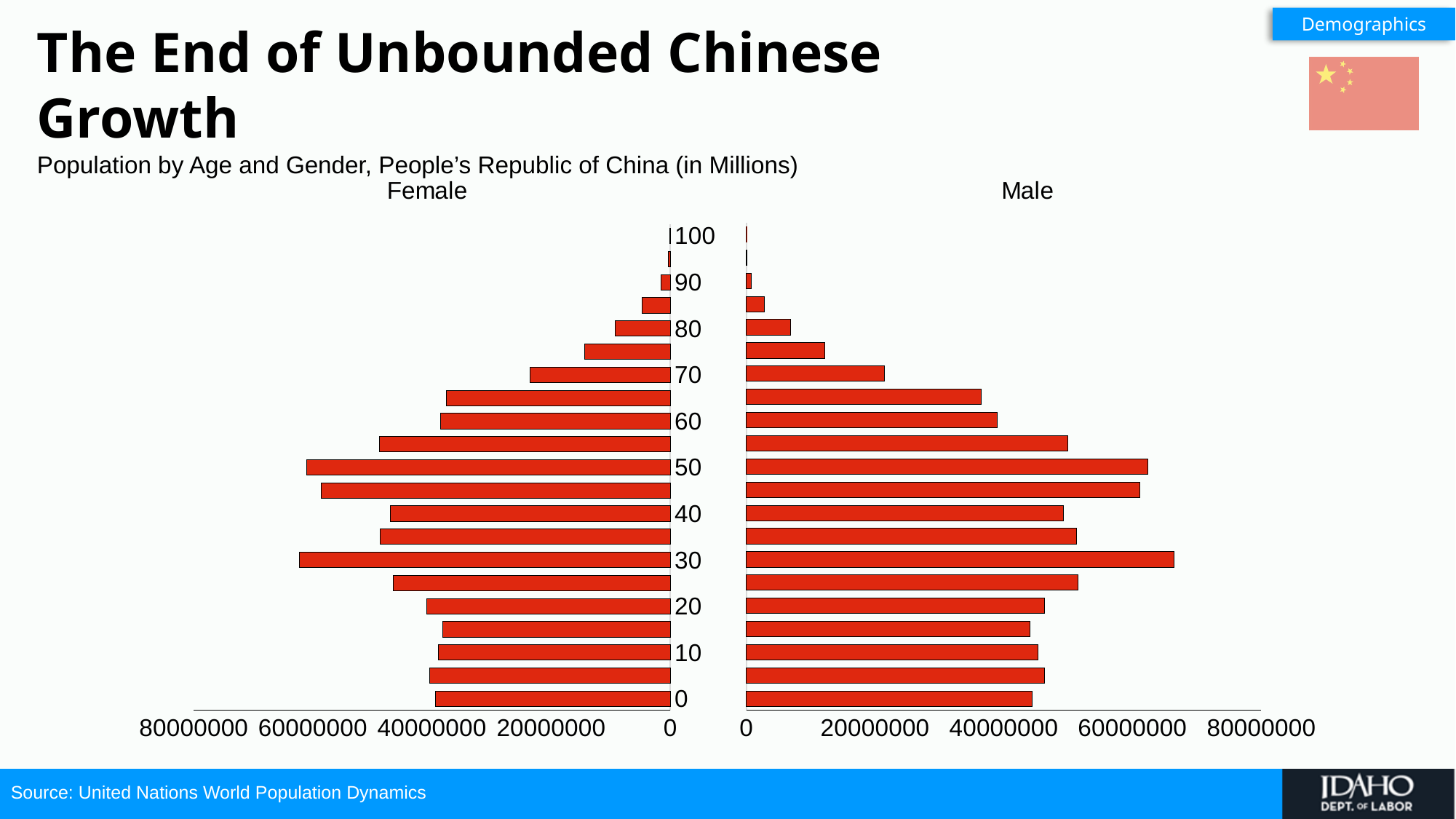
In the Female chart, which age group has the shortest bar? 100 What kind of chart is shown on the slide? bar chart In the Male chart, do the values rise or fall as age increases from 60 to 100? fall In the Female chart, which is larger, the value for age 30 or the value for age 70? age 30 In the Male chart, which age group has the longest bar? 30 In the Male chart, is the value for age 0 greater or less than 40000000? greater In the Male chart, which age group has the shortest bar? 100 In the Female chart, is the value for age 40 greater or less than 60000000? less In the Male chart, which is larger, the value for age 50 or the value for age 80? age 50 In the Female chart, is the value for age 80 greater or less than 20000000? less In the Female chart, how many bars are plotted? 21